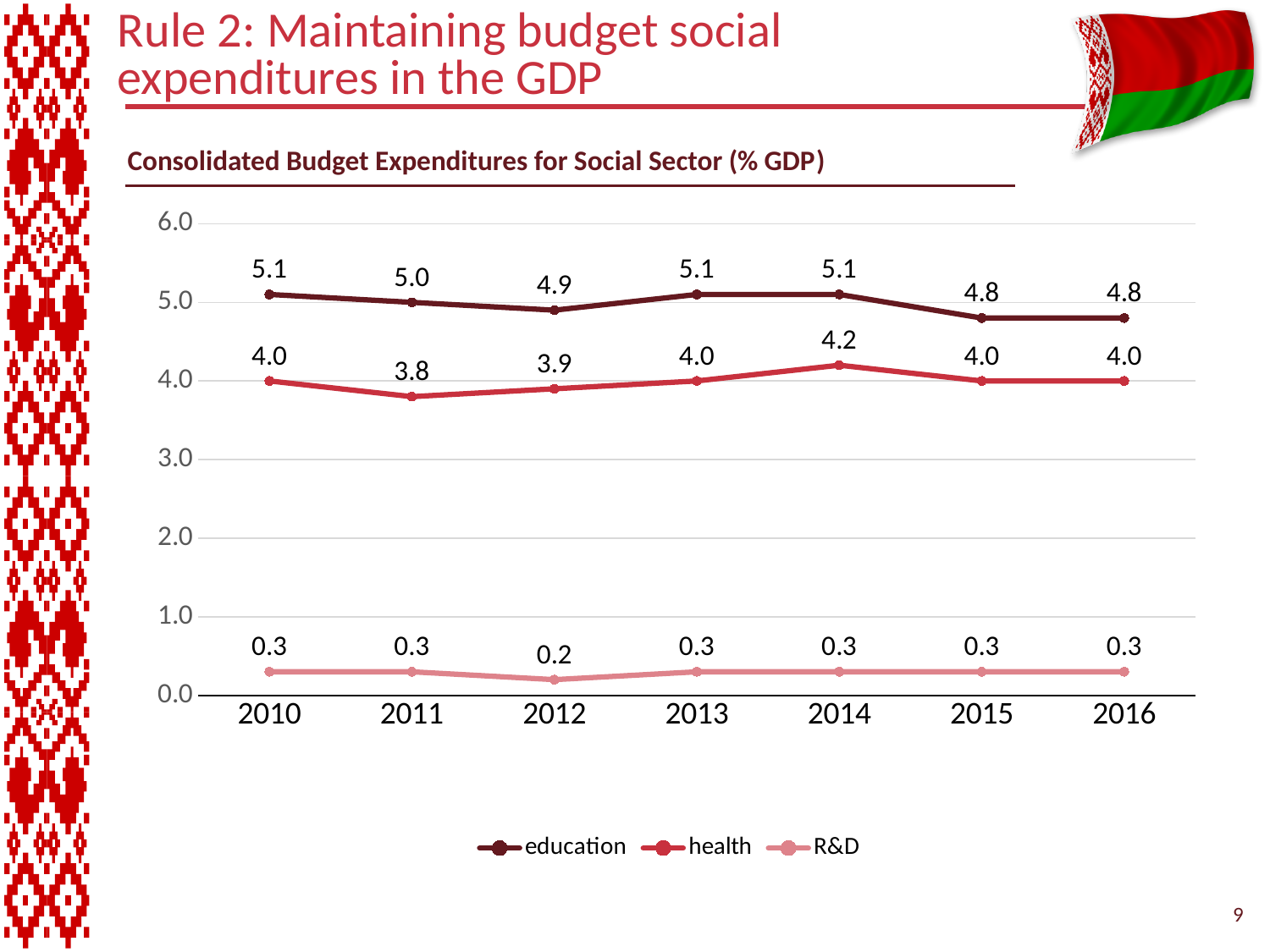
In which year is the health series at its highest? 2014 What is the education expenditure value for 2012? 4.9 Which is larger in 2015, the education value or the health value? education What is the difference between the education and health values in 2010? 1.1 What is the title of the chart? Consolidated Budget Expenditures for Social Sector (% GDP) How many years are shown on the x axis? 7 How many series does the legend list? 3 Does the education series rise or fall from 2014 to 2016? fall What kind of chart is shown on the slide? line chart What is the health expenditure value for 2014? 4.2 In which year is the health series at its lowest? 2011 What is the R&D expenditure value for 2012? 0.2